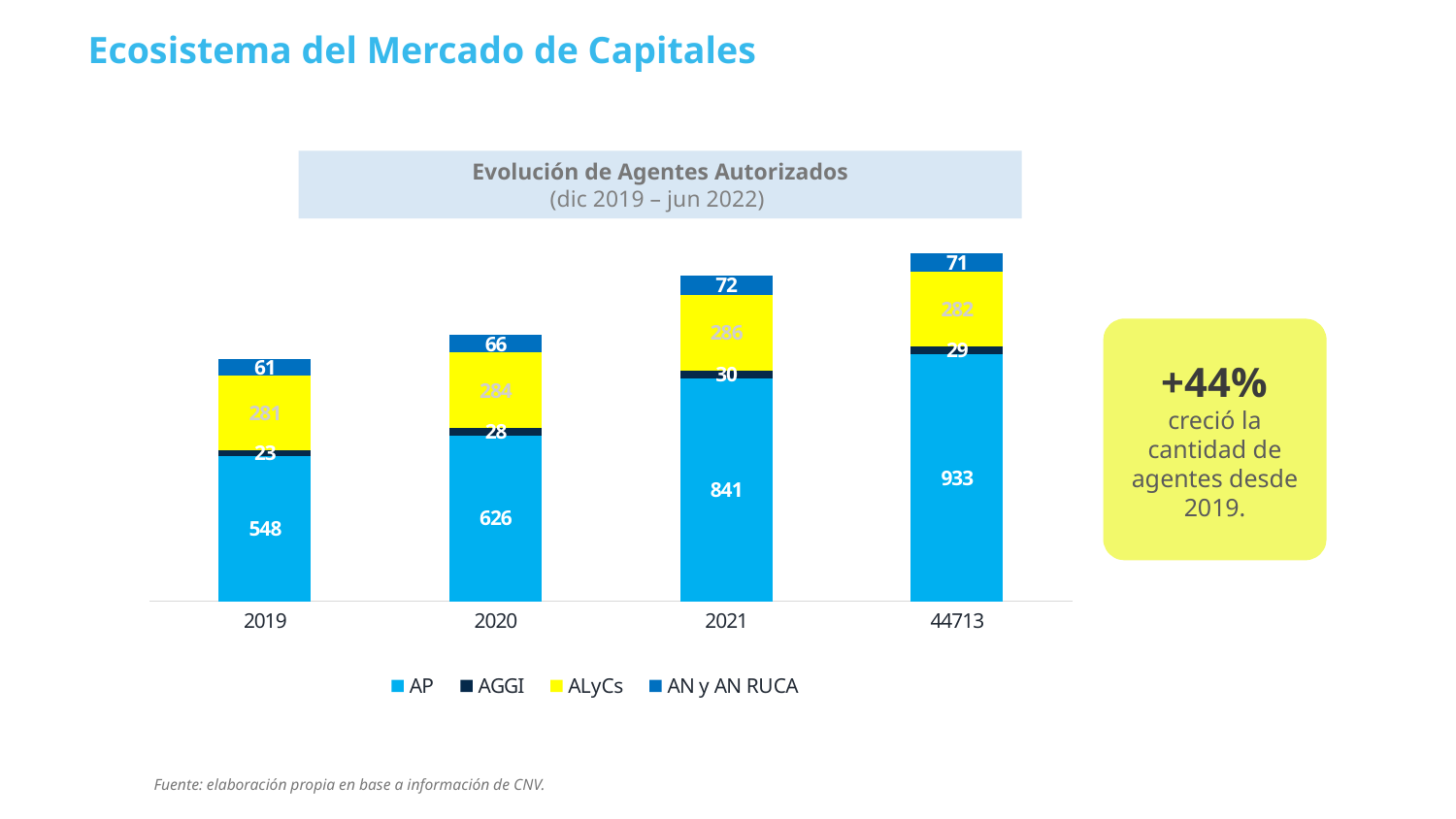
What is the value of AN y AN RUCA for the last category, labelled 44713? 71 What is the value of ALyCs for 2020? 284 How many series does the legend list? 4 Which is larger, the AN y AN RUCA value for 2021 or for 2019? 2021 What is the value of AP for 2021? 841 What is the difference between the AP value for 2021 and the AP value for 2020? 215 What is the total of the stacked bar for 2019? 913 Which category has the lowest AGGI value? 2019 Which category has the highest AP value? 44713 What kind of chart is shown on the slide? Stacked bar chart How many categories are shown on the x axis? 4 What is the value of AP for 2019? 548